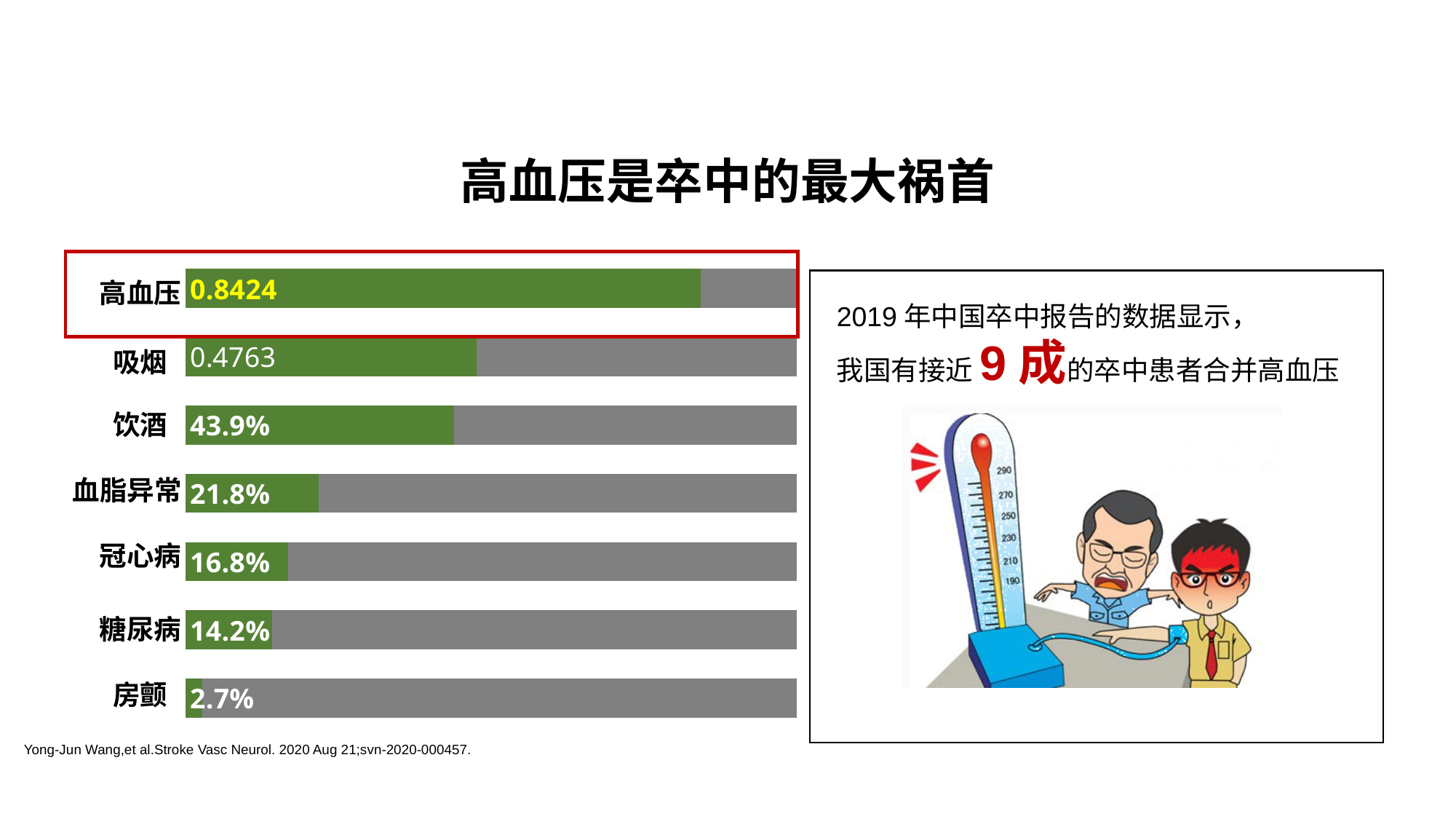
How many categories are shown in the bar chart? 7 Which has a larger value, 血脂异常 or 冠心病? 血脂异常 What is the difference between the values for 冠心病 and 糖尿病? 2.6% What is the difference between the values for 饮酒 and 血脂异常? 22.1% What is the value shown for 吸烟 in the bar chart? 0.4763 What is the value shown for 饮酒 in the bar chart? 43.9% Which category has the lowest value in the bar chart? 房颤 What kind of chart is shown on the slide? Bar chart Which category's bar is outlined with a red box on the slide? 高血压 What is the value shown for 糖尿病 in the bar chart? 14.2% What is the value shown for 高血压 in the bar chart? 0.8424 Which category has the highest value in the bar chart? 高血压